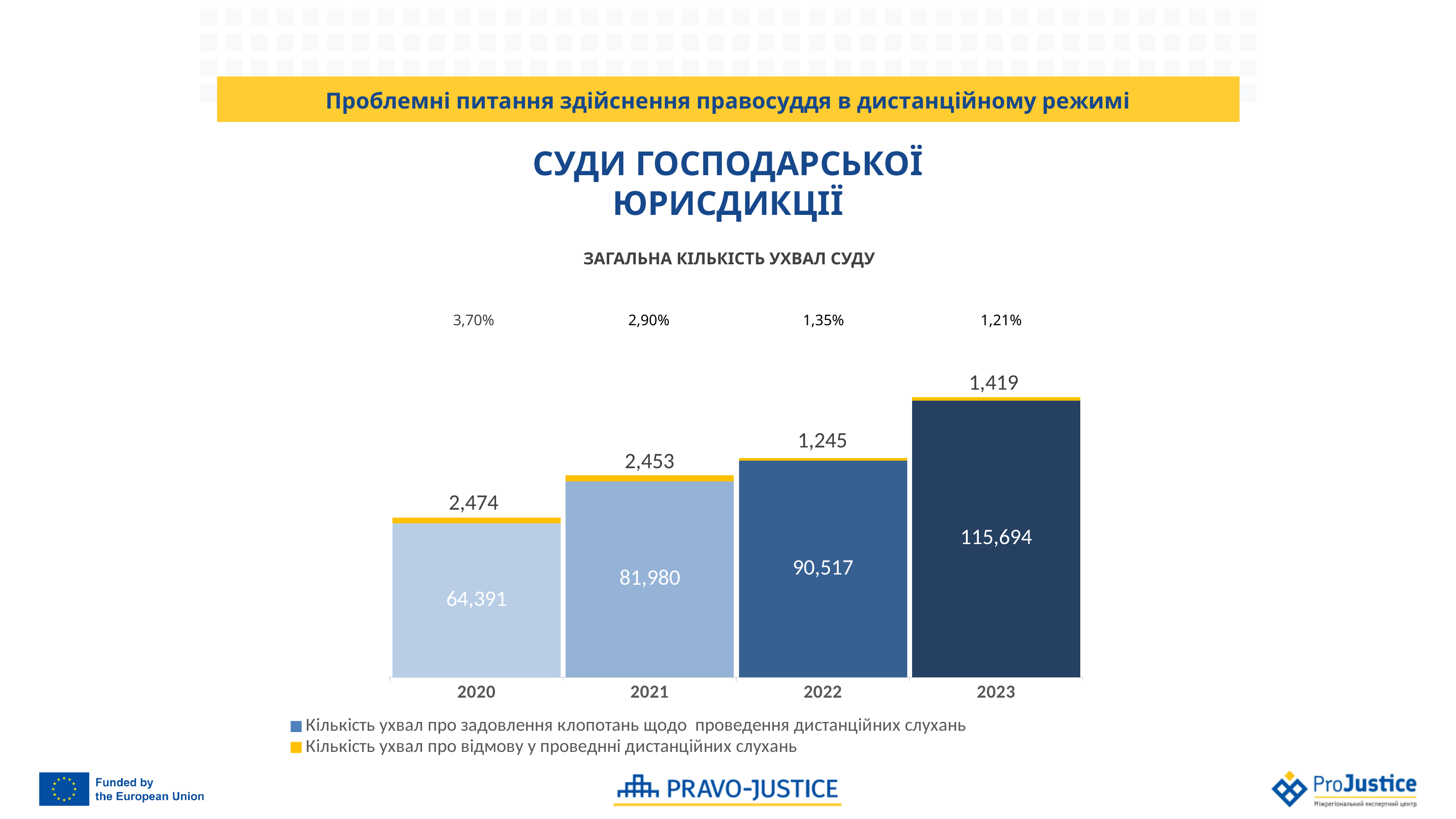
Which year has the lowest number of rulings refusing remote hearings (yellow series)? 2022 What kind of chart is shown on the slide? Stacked bar chart Which is larger: the yellow series value for 2022 or for 2023? 2023 What is the number of rulings granting motions for remote hearings (blue series) in 2023? 115,694 Which year has the highest number of rulings granting motions for remote hearings? 2023 What is the value of the blue series for 2021? 81,980 What percentage is shown above the 2022 bar? 1,35% How many years are shown on the x axis? 4 What is the number of rulings refusing remote hearings (yellow series) in 2020? 2,474 How many series does the legend list? 2 Do the values of the blue series rise or fall from 2020 to 2023? Rise What is the difference between the blue series values for 2023 and 2020? 51,303